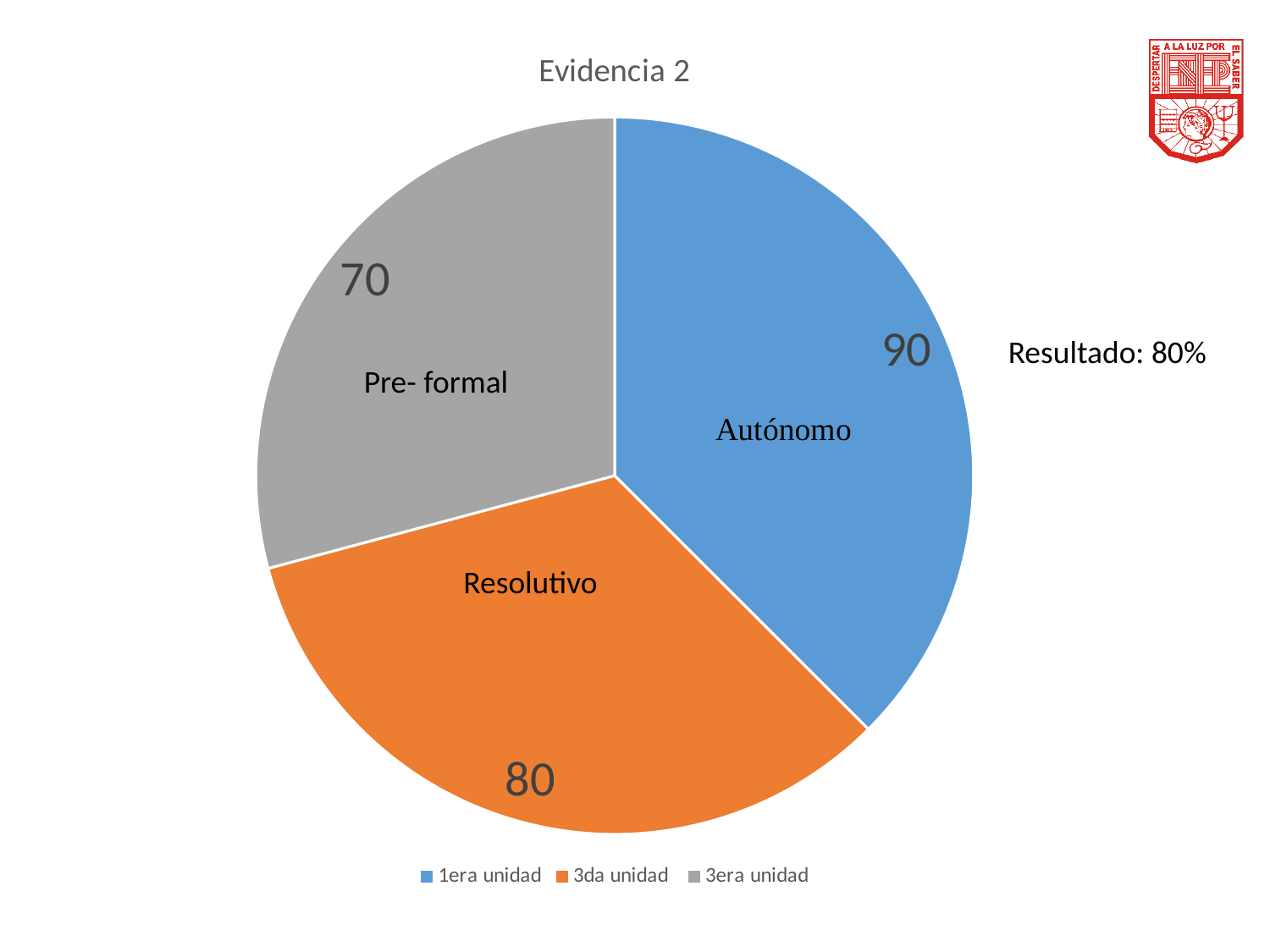
What is the title of the chart? Evidencia 2 Which legend entry has the smallest slice? 3era unidad How many slices does the pie chart have? 3 What type of chart is shown on the slide? pie chart How many entries does the legend list? 3 What is the value for 3da unidad? 80 What is the difference between the values for 1era unidad and 3era unidad? 20 Which legend entry has the largest slice? 1era unidad What is the value for 3era unidad? 70 What is the value for 1era unidad? 90 What share of the pie does the 1era unidad slice represent? 37.5% Which is larger, the value for 3da unidad or the value for 3era unidad? 3da unidad